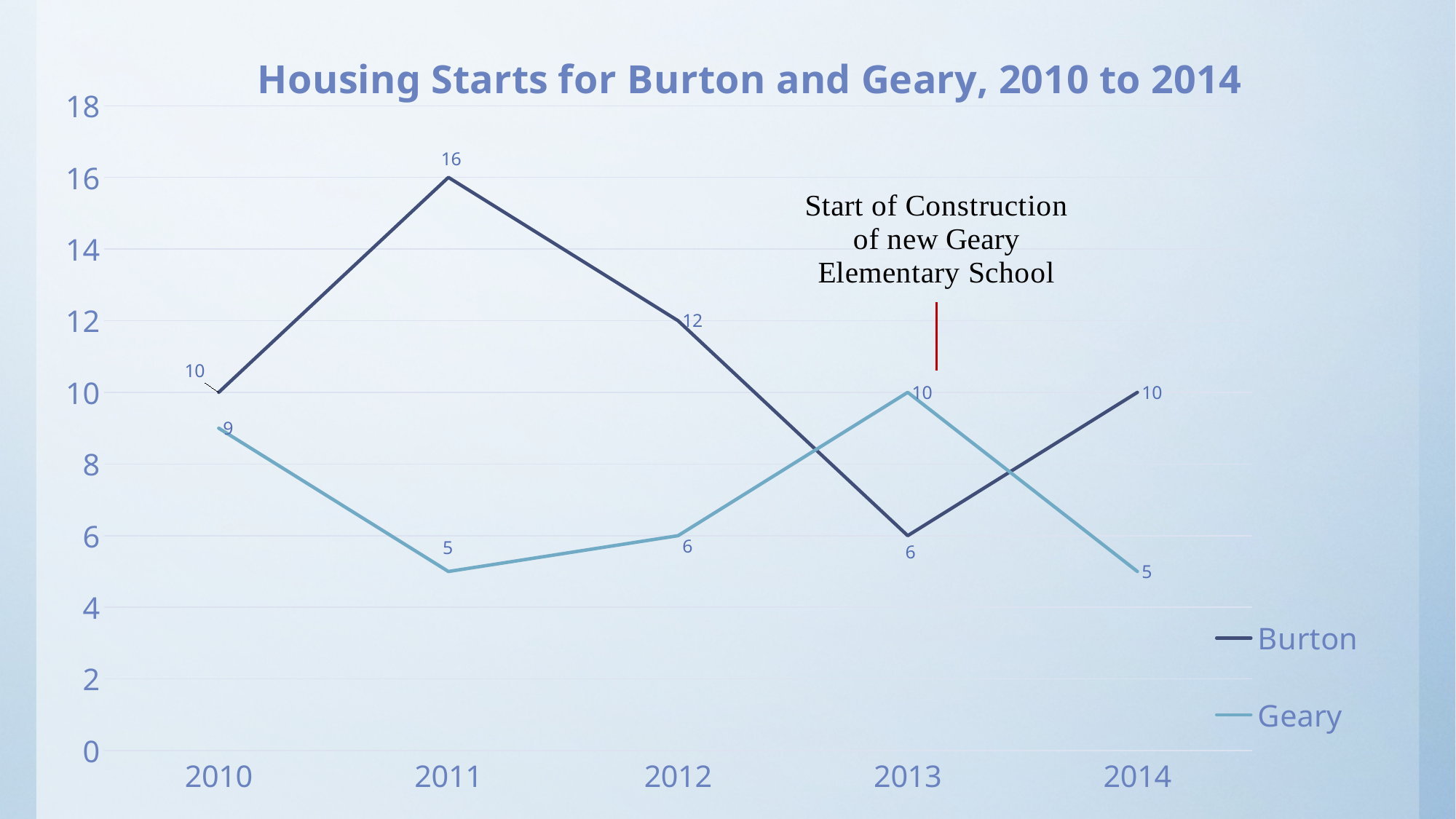
What kind of chart is shown on the slide? Line chart What is the value for Burton in 2011? 16 In which year is the Burton series at its highest? 2011 What is the value for Geary in 2013? 10 What is the difference between Burton and Geary in 2012? 6 Does the Geary series rise or fall from 2013 to 2014? Fall How many years are plotted on the x axis? 5 How many series does the legend list? 2 In which year is the Burton series at its lowest? 2013 What is the title of the chart? Housing Starts for Burton and Geary, 2010 to 2014 What is the value for Geary in 2014? 5 Which series has the larger value in 2013, Burton or Geary? Geary